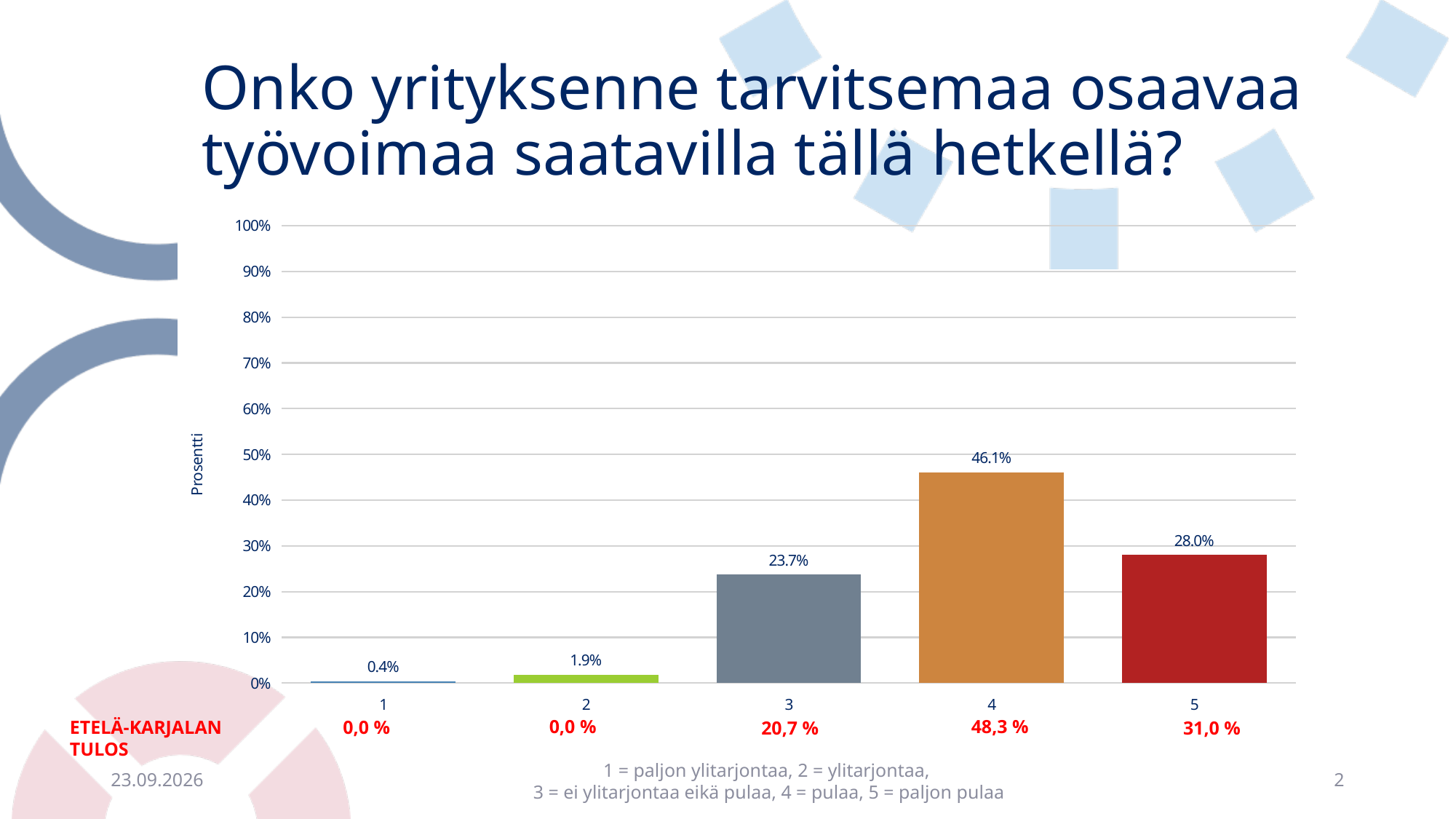
What is the value for category 5? 28.0% What is the difference between the values for category 4 and category 5? 18.1% Is the value for category 4 greater or less than 40%? greater How many categories are shown on the x axis? 5 What is the value for category 1? 0.4% What kind of chart is shown on the slide? bar chart What is the value for category 4? 46.1% What is the label of the vertical axis? Prosentti Which is larger, the value for category 3 or the value for category 5? 5 Which category has the lowest value? 1 What is the value for category 3? 23.7% Which category has the highest value? 4